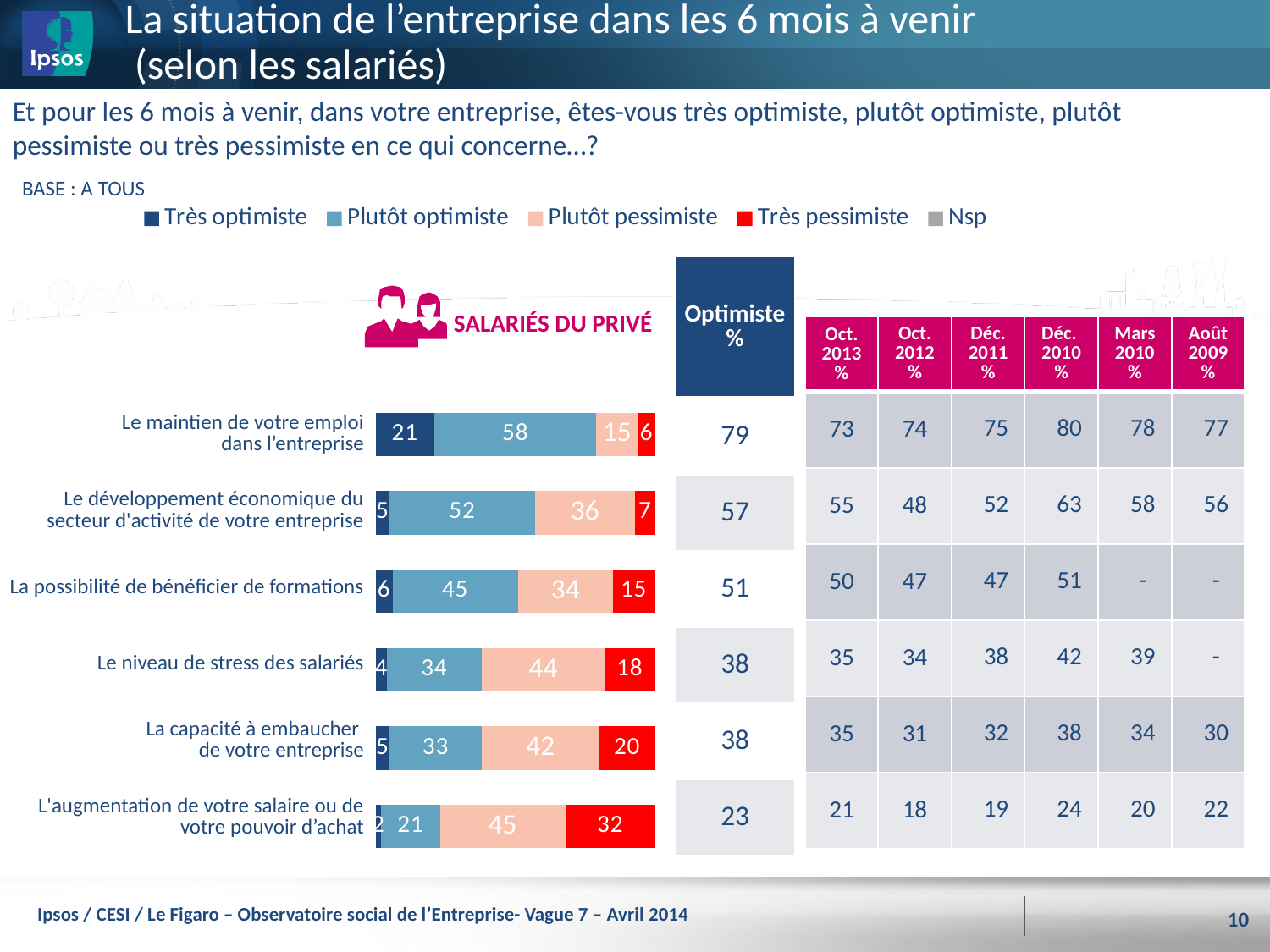
Which category has the highest "Très optimiste" value? Le maintien de votre emploi dans l'entreprise What kind of chart is shown on the slide? Stacked bar chart Which is larger: the "Plutôt pessimiste" value for "Le développement économique du secteur d'activité de votre entreprise" or for "La possibilité de bénéficier de formations"? Le développement économique du secteur d'activité de votre entreprise What is the value for "Très pessimiste" for "L'augmentation de votre salaire ou de votre pouvoir d'achat"? 32 What is the value for "Plutôt pessimiste" for "Le niveau de stress des salariés"? 44 Which colour represents "Très pessimiste" in the legend? Red How many series does the legend list? 5 What is the difference between the "Très pessimiste" values for "La capacité à embaucher de votre entreprise" and "La possibilité de bénéficier de formations"? 5 What is the total of the "Très optimiste" and "Plutôt optimiste" values for "Le niveau de stress des salariés"? 38 How many categories are shown in the bar chart? 6 Which category has the lowest "Plutôt optimiste" value? L'augmentation de votre salaire ou de votre pouvoir d'achat What is the value for "Plutôt optimiste" for "Le maintien de votre emploi dans l'entreprise"? 58